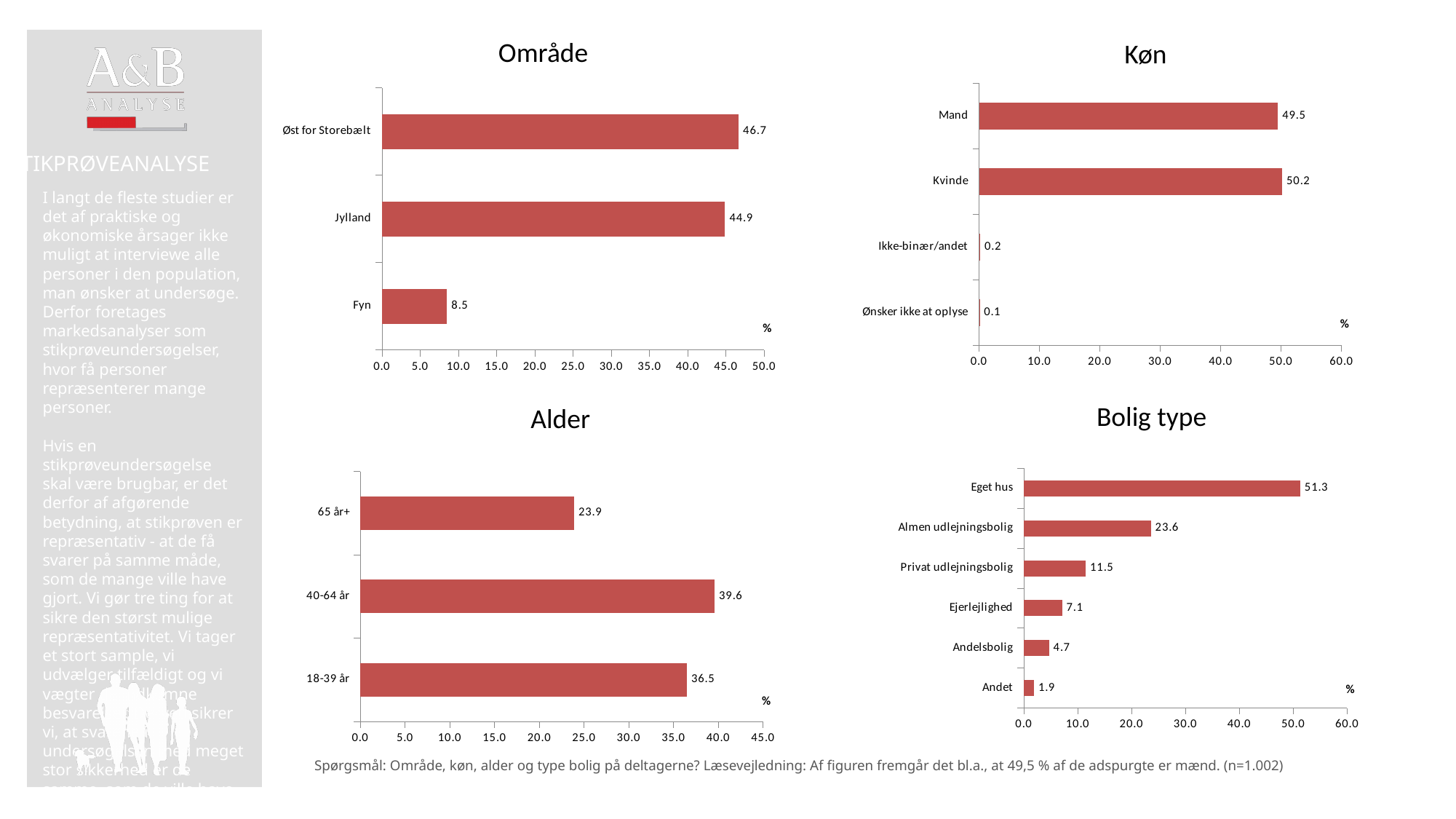
In the 'Alder' chart, which age group has the highest value? 40-64 år In the 'Område' chart, what is the value for Jylland? 44.9 In the 'Køn' chart, how many categories are shown? 4 In the 'Alder' chart, which is larger: 18-39 år or 65 år+? 18-39 år In the 'Område' chart, what is the difference between Øst for Storebælt and Fyn? 38.2 What kind of chart is the 'Bolig type' chart? Bar chart In the 'Alder' chart, what is the value for 65 år+? 23.9 In the 'Bolig type' chart, how many categories are shown? 6 In the 'Køn' chart, what is the value for Ikke-binær/andet? 0.2 In the 'Område' chart, which category has the lowest value? Fyn In the 'Bolig type' chart, what is the value for Privat udlejningsbolig? 11.5 In the 'Køn' chart, what is the value for Kvinde? 50.2